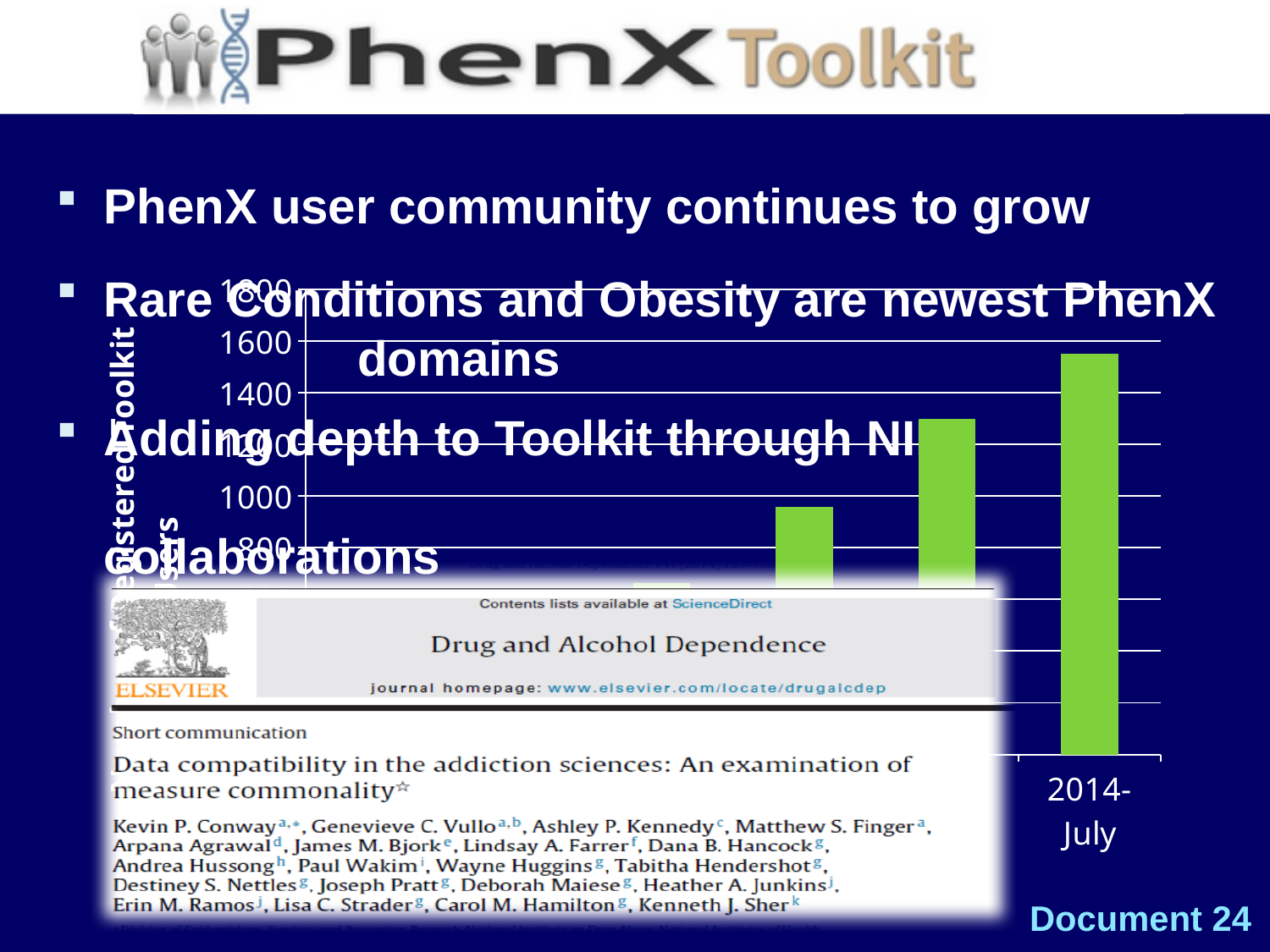
What is the highest value shown on the chart's vertical axis? 1800 What colour are the bars in the chart? green Do the bar values rise or fall from left to right across the chart? rise Which is larger: the 2014-July bar or the bar immediately to its left? 2014-July Is the bar immediately to the left of 2014-July greater or less than 1200? greater Is the bar immediately to the left of 2014-July greater or less than 1400? less What kind of chart is shown on the slide? bar chart Is the value for 2014-July greater or less than 1600? less Is the bar labeled 2014-July the tallest bar in the chart? yes